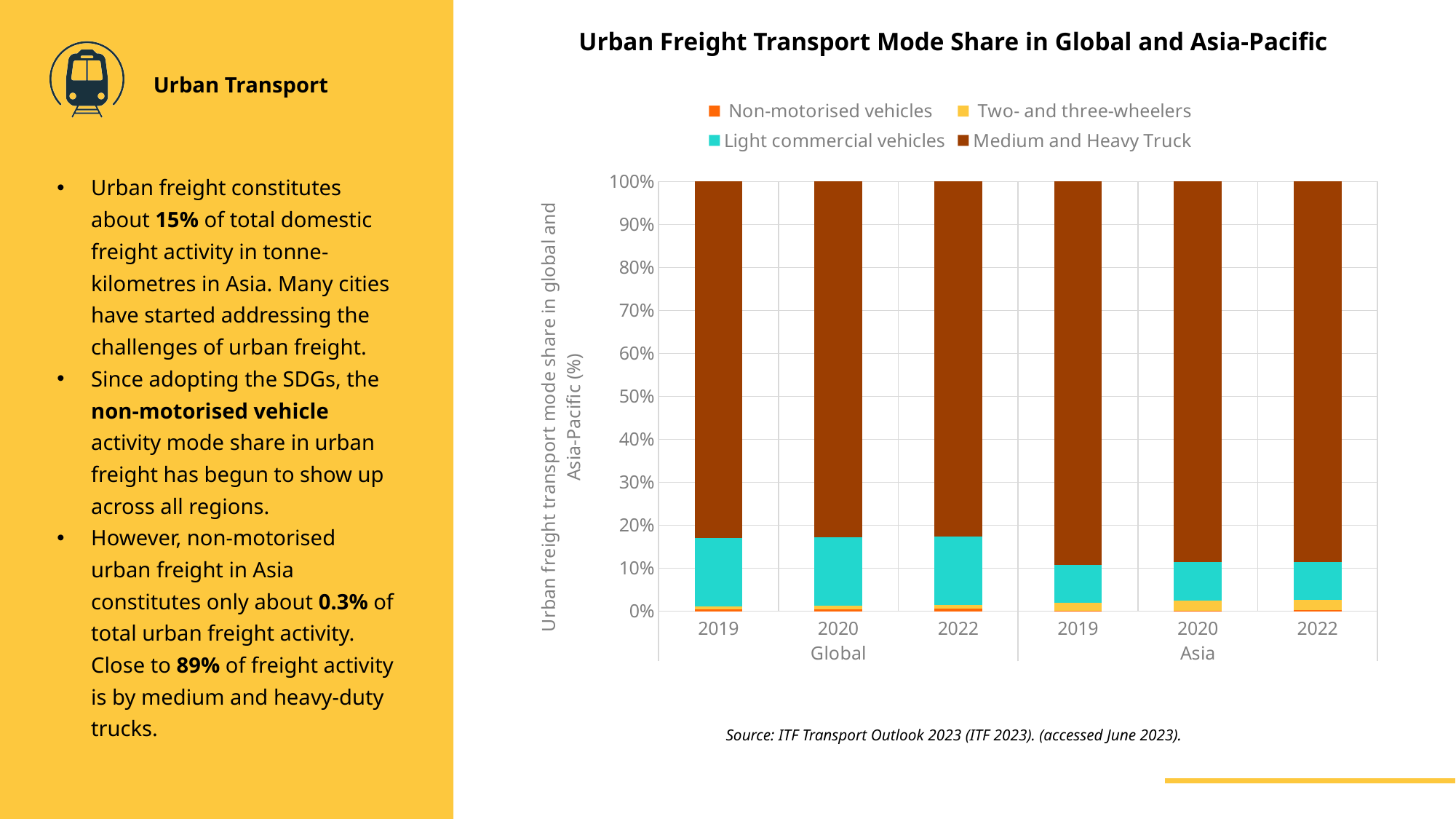
How many series does the legend list? 4 What kind of chart is shown on the slide? Stacked bar chart How many bars are plotted in the chart? 6 Is the Two- and three-wheelers share for Asia 2022 greater or less than 10%? less Which has the larger Light commercial vehicles share, Global 2019 or Asia 2019? Global 2019 Is the Light commercial vehicles share for Global 2022 greater or less than 10%? greater Is the Medium and Heavy Truck share for Global 2019 greater or less than 80%? greater Which has the larger Medium and Heavy Truck share, Global 2022 or Asia 2022? Asia 2022 Which series is shown in dark brown in the legend? Medium and Heavy Truck What is the title of the chart? Urban Freight Transport Mode Share in Global and Asia-Pacific What is the total of the stacked bar for Asia 2020? 100%